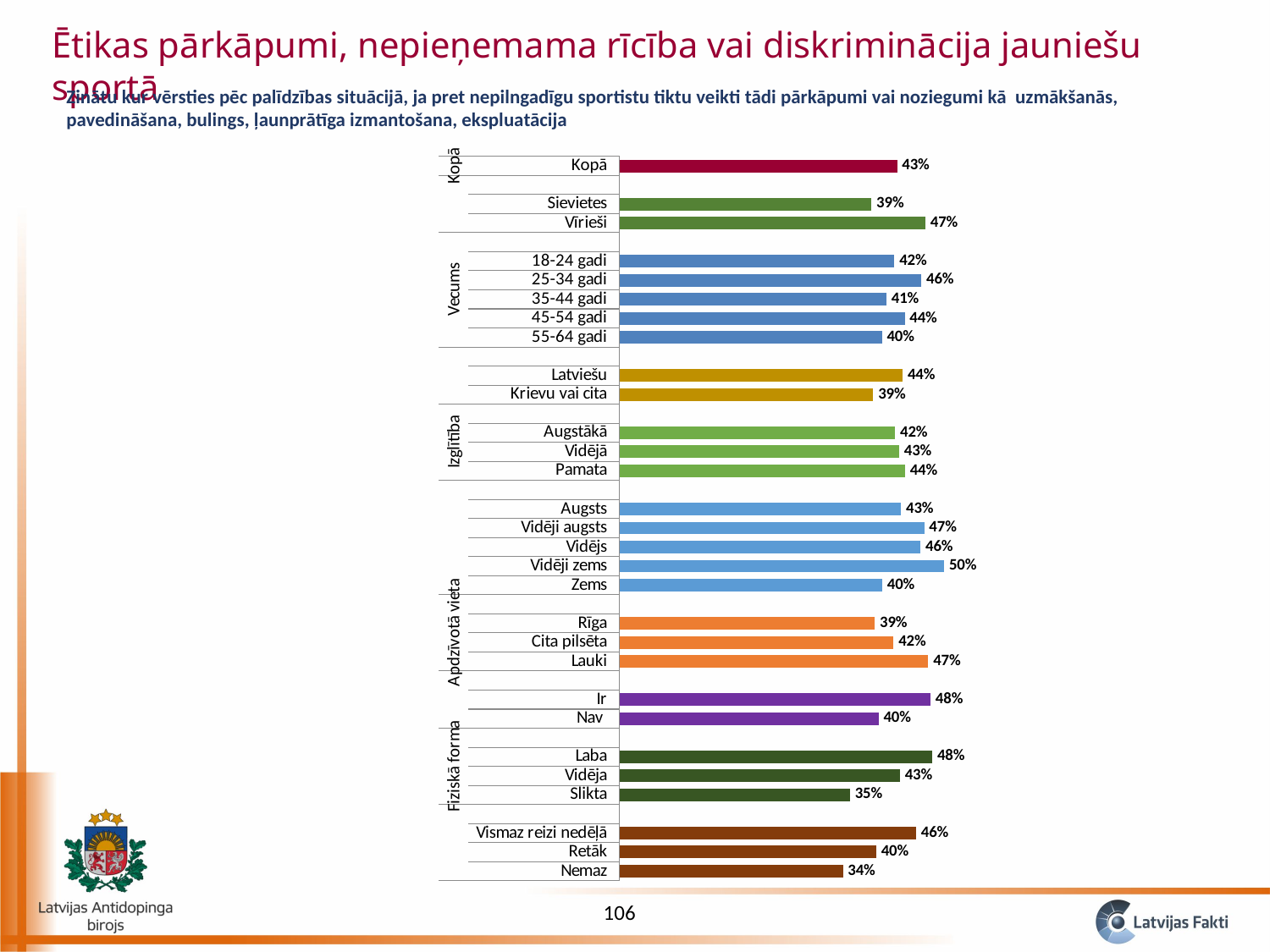
What is the value for Vīrieši? 47% Which is larger, the value for Lauki or the value for Rīga? Lauki Which is larger, the value for Ir or the value for Nav? Ir Which category has the lowest value in the chart? Nemaz What kind of chart is shown on the slide? Bar chart What is the value for Krievu vai cita? 39% Which category has the highest value in the chart? Vidēji zems What is the value for Kopā? 43% What is the value for 25-34 gadi? 46% How many bars are plotted in the chart? 29 What is the difference between the values for Vīrieši and Sievietes? 8% What is the difference between the values for Laba and Slikta? 13%